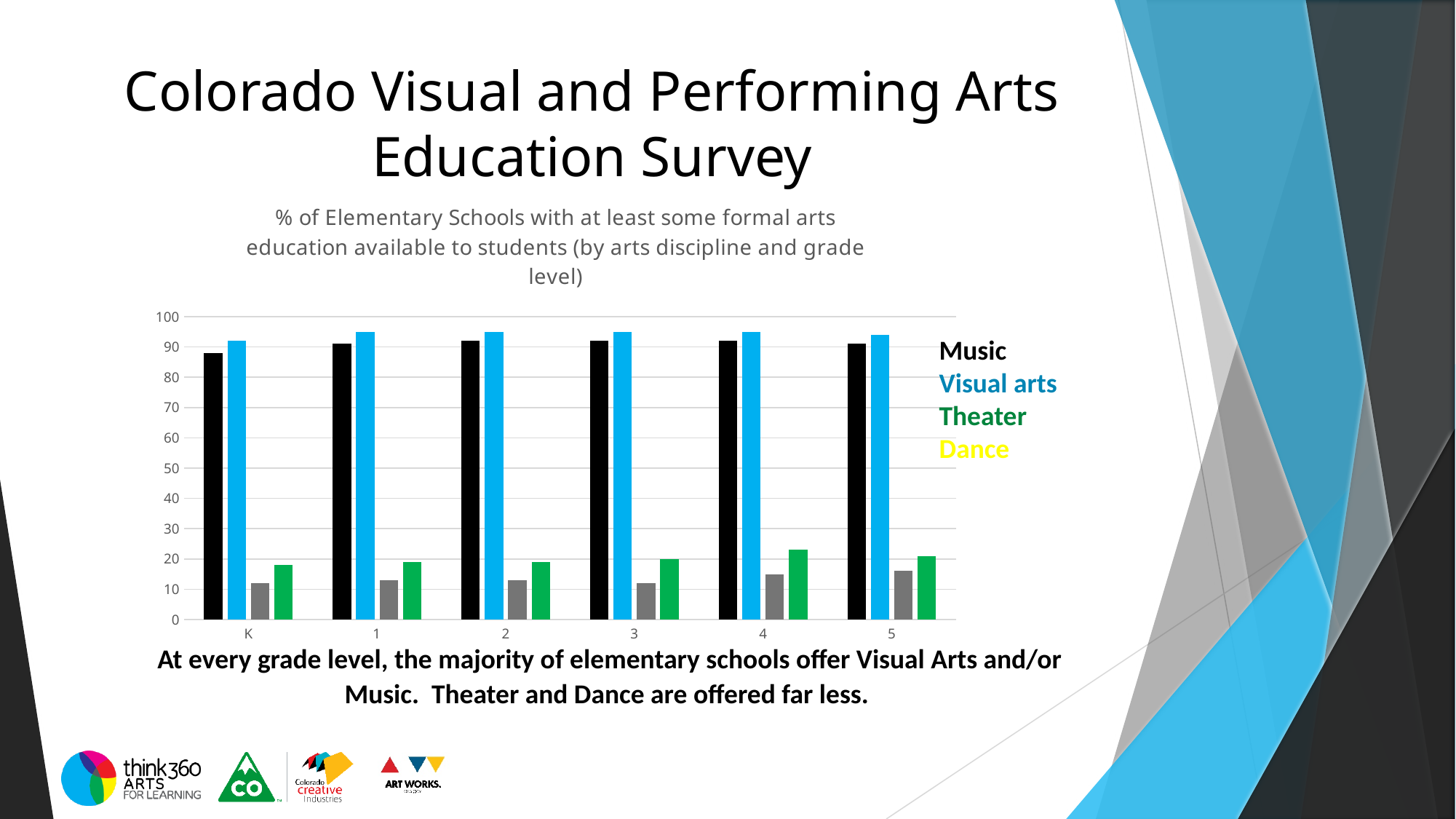
What kind of chart is shown on the slide? bar chart Is the value for Visual arts at grade 1 greater or less than 90? greater Which series has the highest value at grade K? Visual arts Is the value for Music at grade K greater or less than 80? greater What are the four series listed in the legend? Music, Visual arts, Theater, Dance At grade K, which is larger: Music or Visual arts? Visual arts How many grade levels are shown on the x axis of the chart? 6 What are the grade-level categories on the x axis? K, 1, 2, 3, 4, 5 Is the value of the green bar at grade 4 greater or less than 20? greater How many series does the chart's legend list? 4